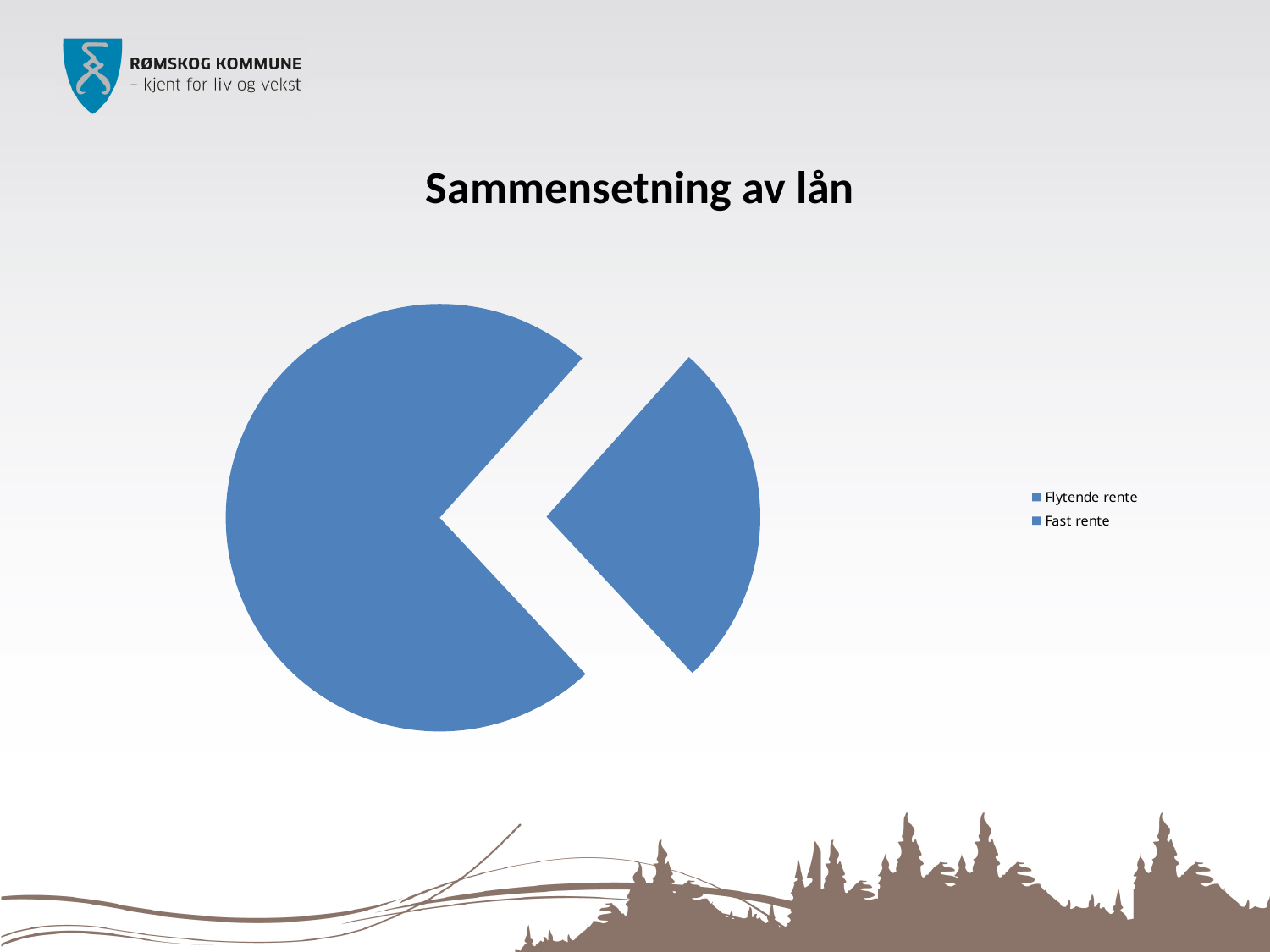
How many slices does the pie chart have? 2 Is the exploded (separated) slice of the pie chart larger or smaller than half of the pie? smaller What kind of chart is shown on the slide? pie chart How many entries does the chart's legend list? 2 What are the two categories listed in the chart's legend? Flytende rente and Fast rente What is the title of the chart on the slide? Sammensetning av lån